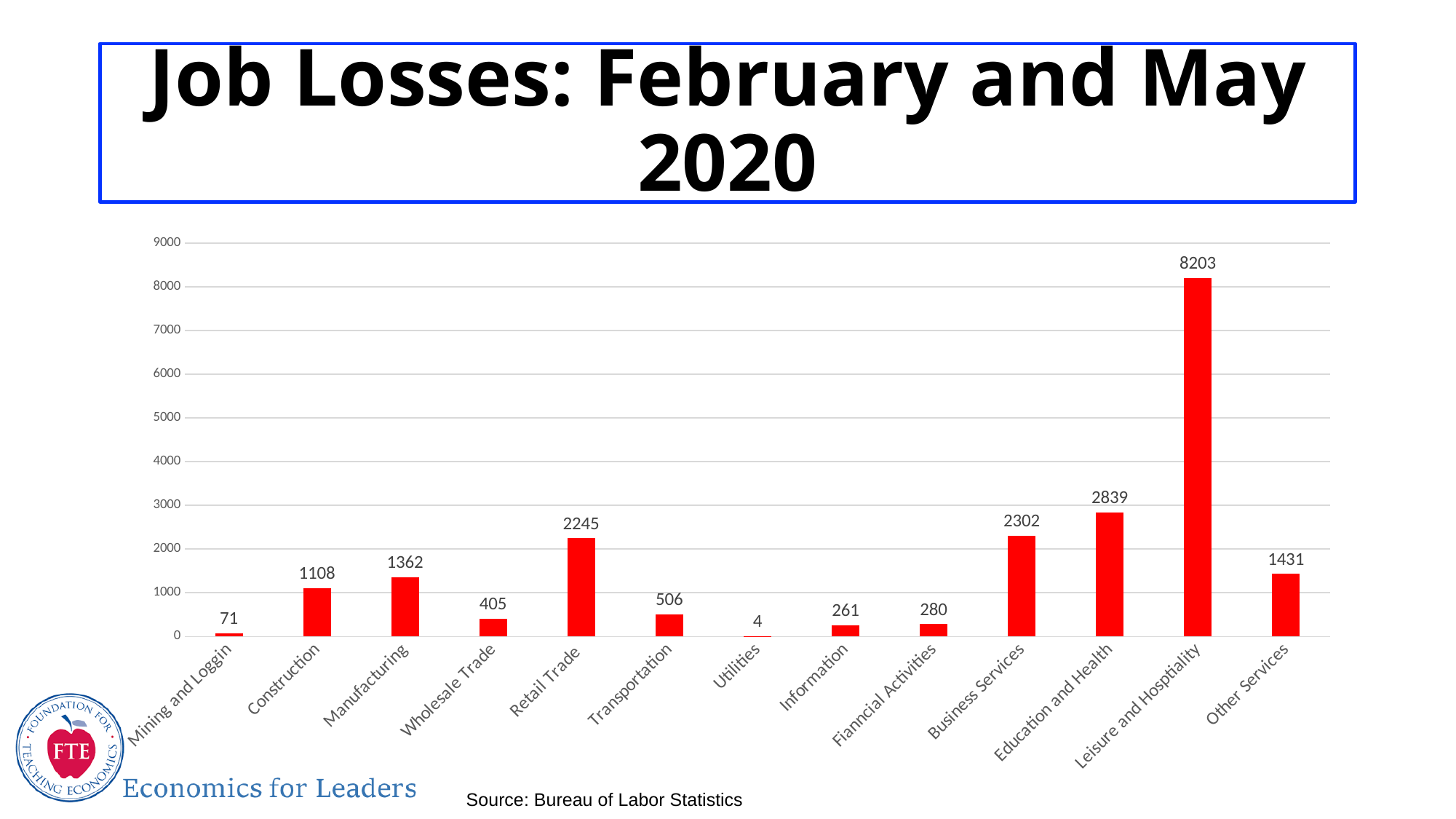
Which category has the lowest value? Utilities What kind of chart is shown on the slide? bar chart What is the title of the slide? Job Losses: February and May 2020 What is the difference between the values for Leisure and Hosptiality and Education and Health? 5364 What is the value shown for Transportation? 506 What is the value shown for Education and Health? 2839 What is the value shown for Retail Trade? 2245 Which is larger, the value for Manufacturing or the value for Construction? Manufacturing Which category has the highest value? Leisure and Hosptiality What is the difference between the values for Business Services and Retail Trade? 57 Is the value for Other Services greater or less than 1000? greater How many categories are shown on the x axis? 13